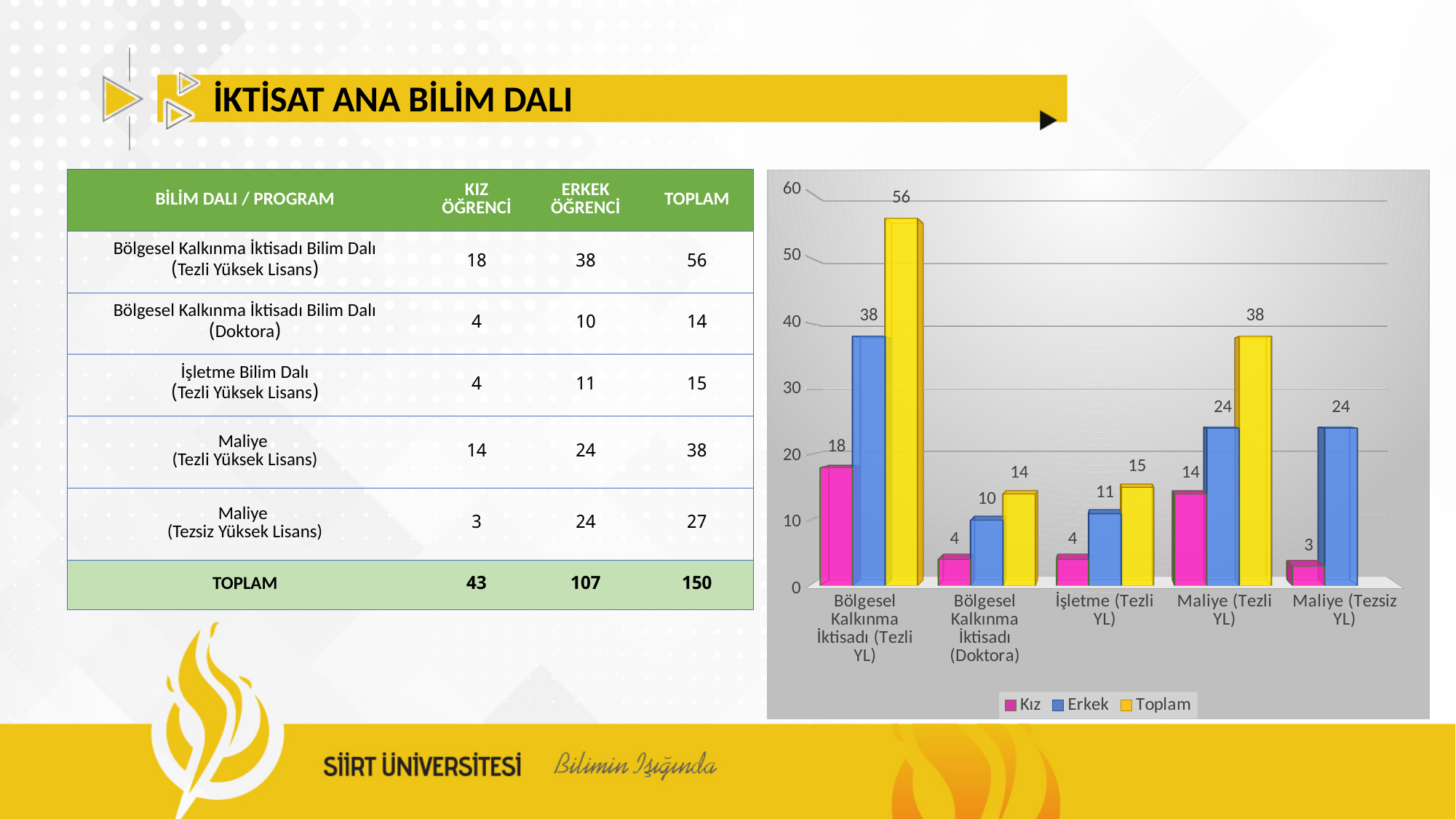
What is the Kız value for Maliye (Tezsiz YL) in the chart? 3 Which is larger in the chart: the Erkek value for İşletme (Tezli YL) or the Erkek value for Bölgesel Kalkınma İktisadı (Doktora)? İşletme (Tezli YL) How many categories are shown on the x axis of the chart? 5 What is the Erkek value for Maliye (Tezli YL) in the chart? 24 What is the difference between the Erkek and Kız values for Bölgesel Kalkınma İktisadı (Tezli YL)? 20 How many series does the chart legend list? 3 Which category has the highest Toplam value in the chart? Bölgesel Kalkınma İktisadı (Tezli YL) What kind of chart is shown on the slide? bar chart Which series in the chart legend is shown in yellow? Toplam What is the Toplam value for Bölgesel Kalkınma İktisadı (Tezli YL) in the chart? 56 Which category has the lowest Kız value in the chart? Maliye (Tezsiz YL) Is the Toplam value for Maliye (Tezli YL) greater or less than 30? greater